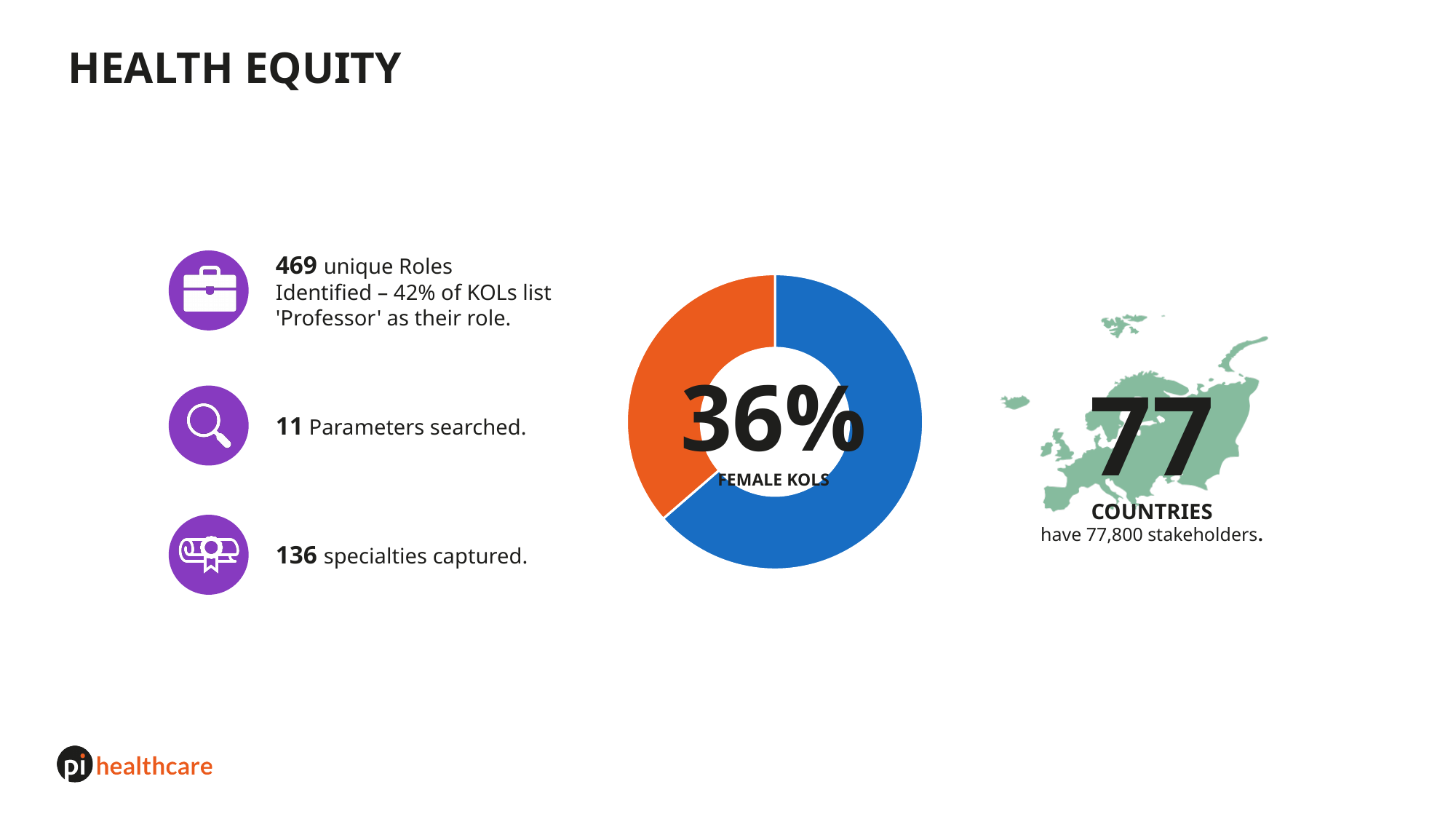
How many slices does the donut chart have? 2 What kind of chart is shown in the middle of the slide? Pie (donut) chart What share of the donut chart is not female KOLs? 64% Which slice of the donut chart is larger, the blue one or the orange one? Blue Is the share represented by the orange slice of the donut chart greater or less than 50%? less What percentage of KOLs are female according to the donut chart? 36% What colour is the slice of the donut chart that represents female KOLs? Orange What label appears in the centre of the donut chart below the percentage? FEMALE KOLS